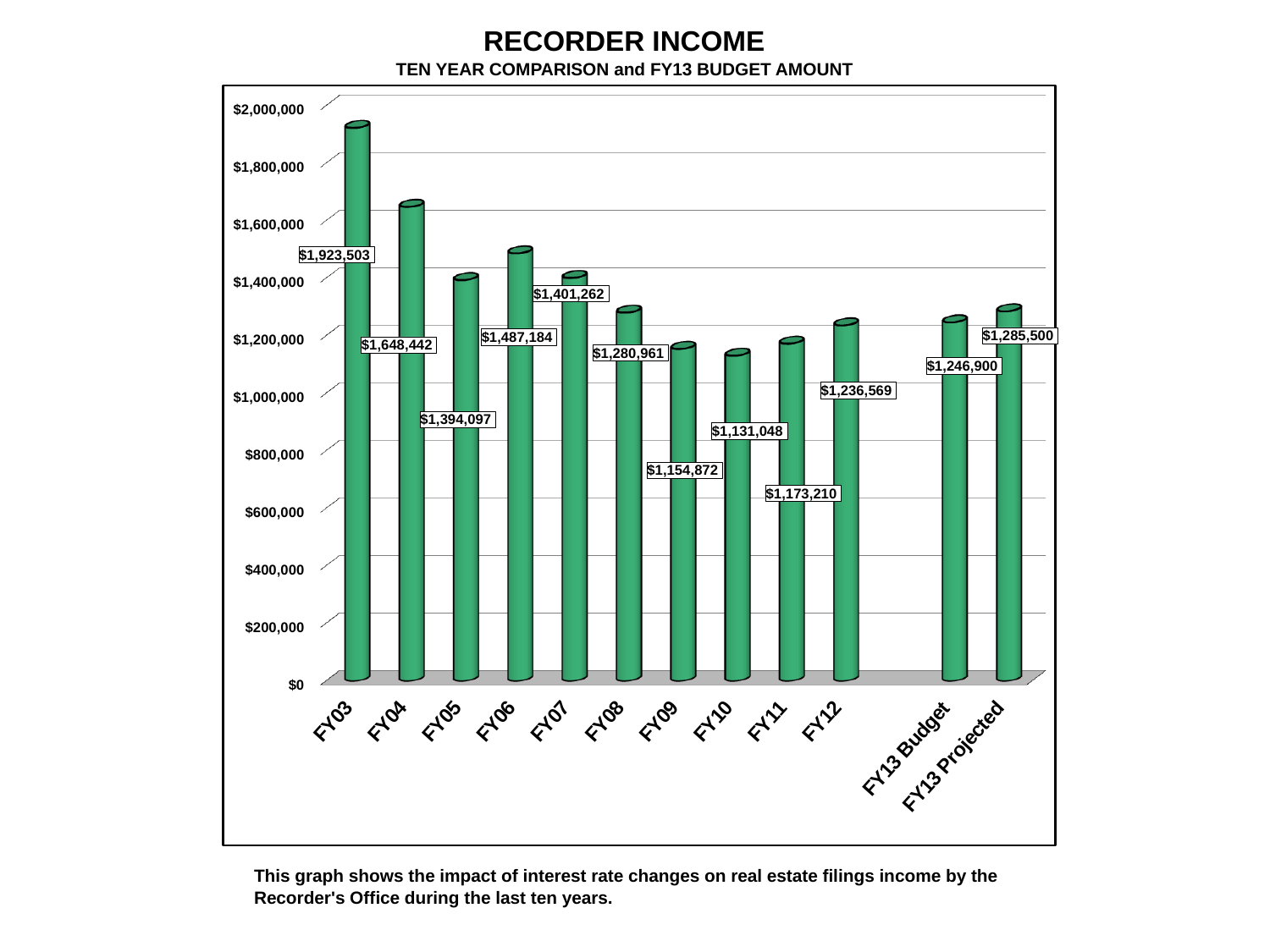
Which fiscal year has the lowest Recorder Income? FY10 What is the Recorder Income value for FY10? $1,131,048 What is the difference between the FY03 and FY04 Recorder Income values? $275,061 How much higher is the FY13 Projected amount than the FY13 Budget amount? $38,600 How many bars are shown on the chart? 12 Which fiscal year has the highest Recorder Income? FY03 Is the Recorder Income for FY04 greater or less than $1,600,000? greater What is the Recorder Income value for FY03? $1,923,503 Which is larger, the Recorder Income for FY06 or for FY07? FY06 What kind of chart is shown on the slide? Bar chart What is the FY13 Budget amount shown on the chart? $1,246,900 What is the FY13 Projected amount shown on the chart? $1,285,500